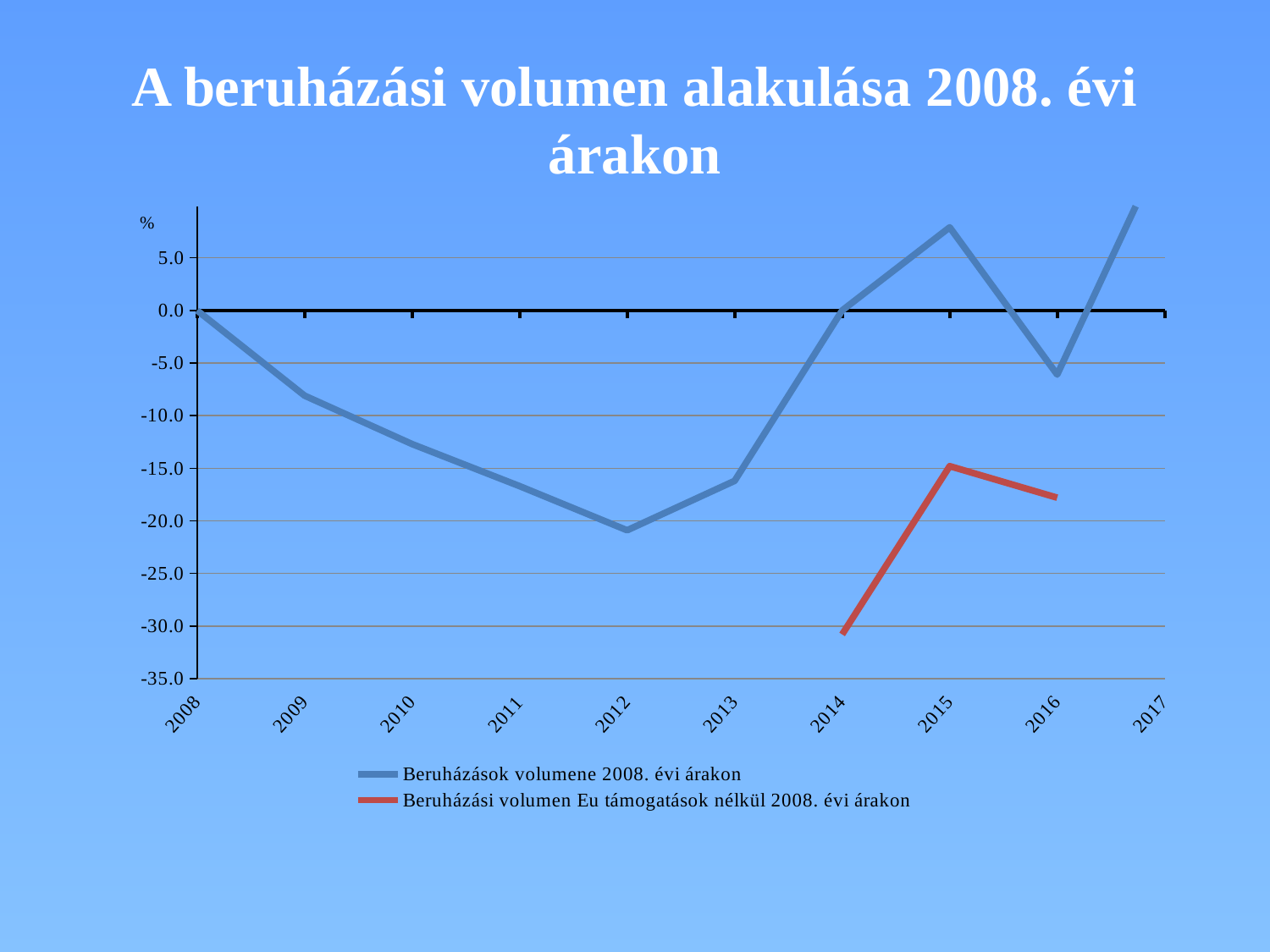
Does the series 'Beruházások volumene 2008. évi árakon' rise or fall from 2008 to 2012? fall In which year does the series 'Beruházások volumene 2008. évi árakon' reach its lowest value? 2012 What kind of chart is shown on the slide? line chart Is the value for 2012 in the series 'Beruházások volumene 2008. évi árakon' greater or less than -20.0? less Is the value for 2015 in the series 'Beruházások volumene 2008. évi árakon' greater or less than 5.0? greater How many years are shown on the x axis? 10 Which series has the higher value in 2015, 'Beruházások volumene 2008. évi árakon' or 'Beruházási volumen Eu támogatások nélkül 2008. évi árakon'? Beruházások volumene 2008. évi árakon Is the value for 2014 in the series 'Beruházási volumen Eu támogatások nélkül 2008. évi árakon' greater or less than -30.0? less In which year does the series 'Beruházási volumen Eu támogatások nélkül 2008. évi árakon' start? 2014 How many series does the legend list? 2 What is the title of the chart? A beruházási volumen alakulása 2008. évi árakon In which year does the series 'Beruházások volumene 2008. évi árakon' reach its highest value? 2017